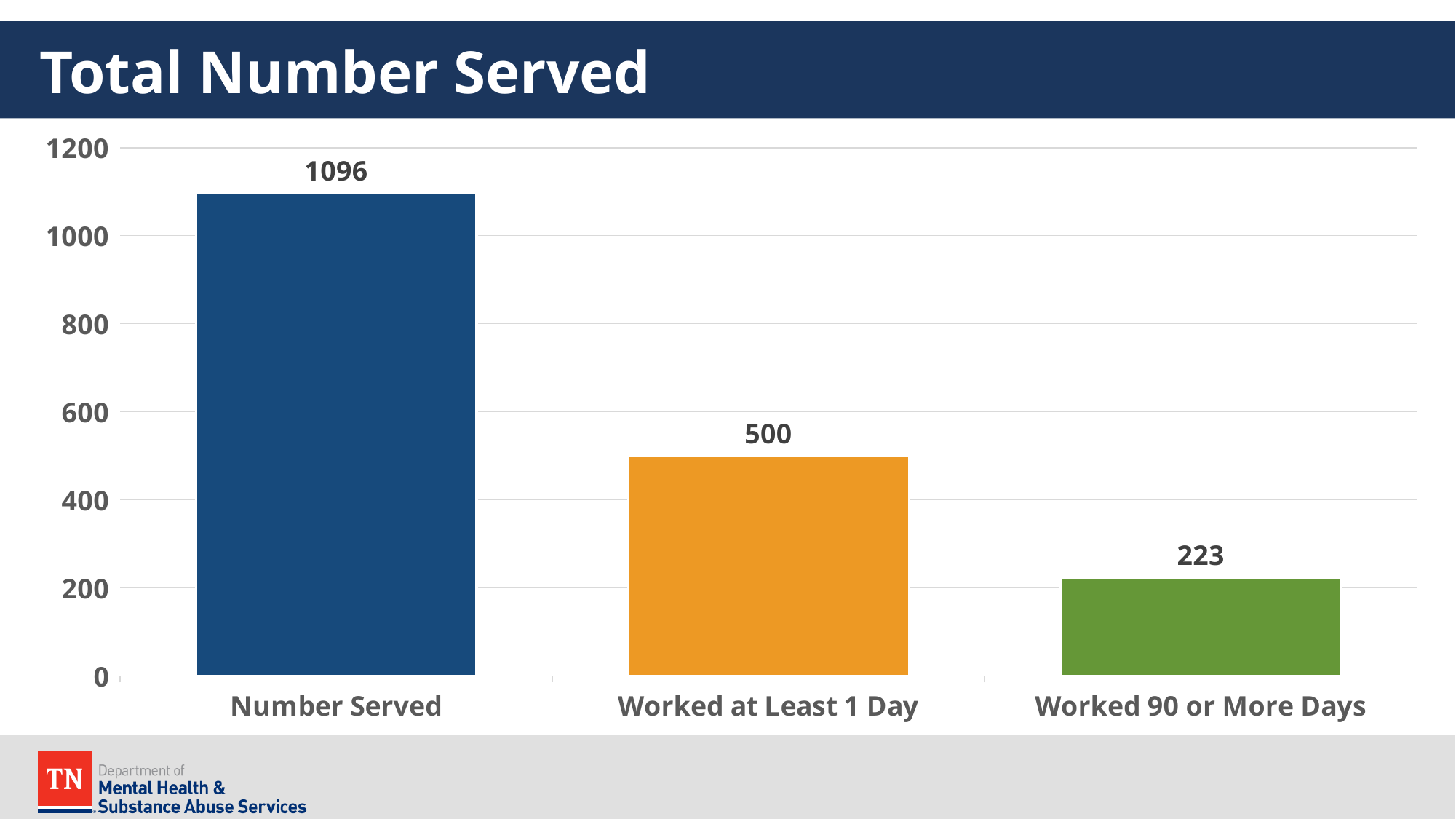
What kind of chart is shown on the slide? Bar chart Which category has the highest value? Number Served What is the difference between Number Served and Worked at Least 1 Day? 596 Which is larger, Worked at Least 1 Day or Worked 90 or More Days? Worked at Least 1 Day What is the title of the slide? Total Number Served Is the value for Worked 90 or More Days greater or less than 400? less What is the value for Worked at Least 1 Day? 500 What is the value for Number Served? 1096 How many categories are shown in the chart? 3 What is the difference between Worked at Least 1 Day and Worked 90 or More Days? 277 What is the value for Worked 90 or More Days? 223 Which category has the lowest value? Worked 90 or More Days